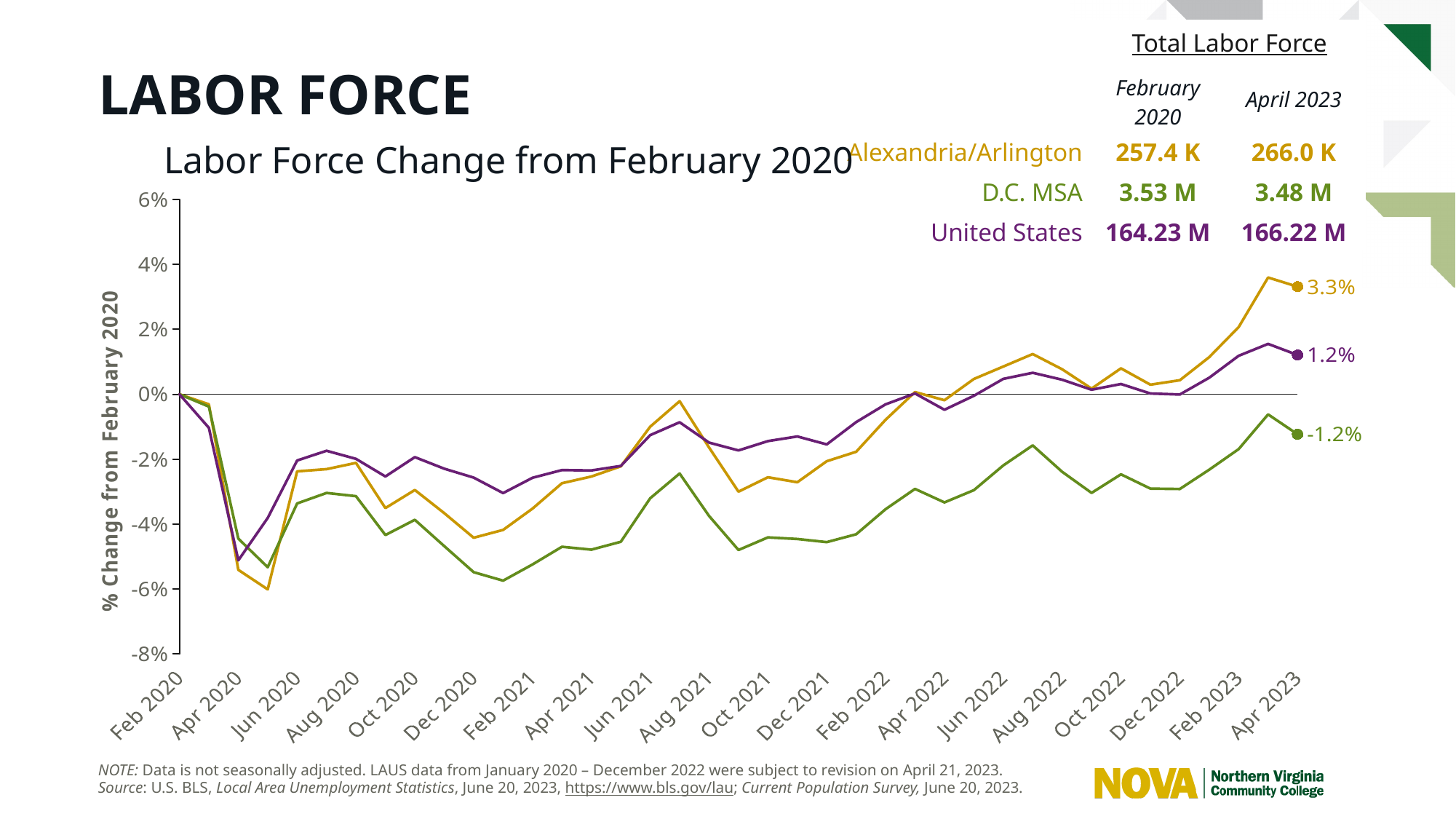
What is the labor force change from February 2020 for the D.C. MSA in April 2023? -1.2% What kind of chart is shown on the slide? line chart In April 2023, which is larger: the value for Alexandria/Arlington or the value for the United States? Alexandria/Arlington Is the value for the D.C. MSA in Jun 2020 greater or less than -4%? greater How many series are plotted on the chart? 3 What is the difference between the April 2023 values for Alexandria/Arlington and the D.C. MSA? 4.5 percentage points What is the title of the vertical axis? % Change from February 2020 What is the labor force change from February 2020 for the United States in April 2023? 1.2% What is the labor force change from February 2020 for Alexandria/Arlington in April 2023? 3.3% Between Feb 2020 and Apr 2020, do the lines rise or fall? fall Which series has the lowest labor force change in April 2023? D.C. MSA Which series has the highest labor force change in April 2023? Alexandria/Arlington